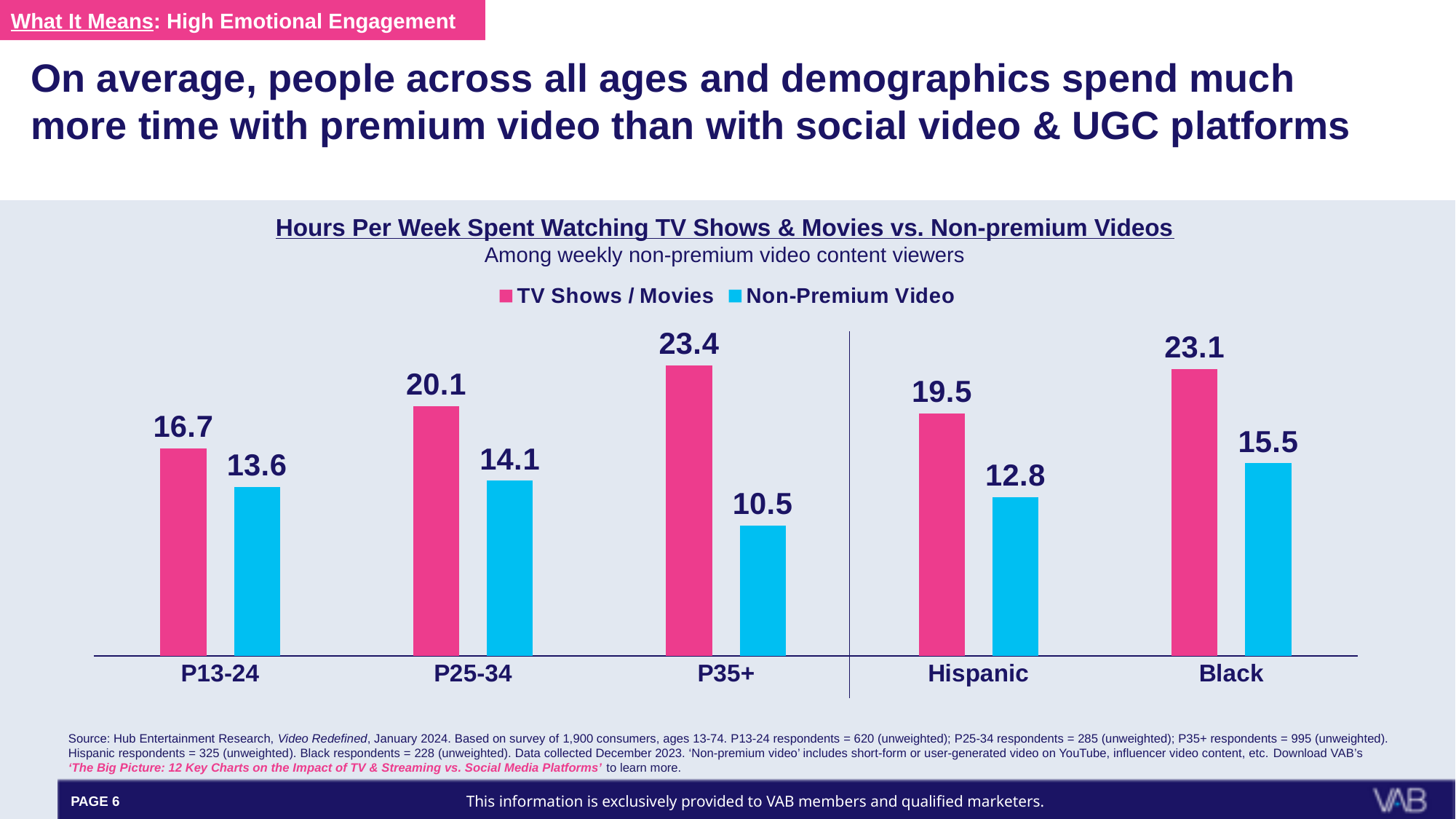
What is the value for Non-Premium Video for Hispanic? 12.8 What is the difference between TV Shows / Movies and Non-Premium Video for P35+? 12.9 What is the difference between TV Shows / Movies and Non-Premium Video for P25-34? 6.0 What is the value for TV Shows / Movies for P13-24? 16.7 How many series does the legend list? 2 Which category has the highest TV Shows / Movies value? P35+ What is the value for TV Shows / Movies for Black? 23.1 How many categories are shown on the x axis? 5 What kind of chart is shown on the slide? Bar chart Which is larger, the Non-Premium Video value for Black or for P13-24? Black What is the value for Non-Premium Video for P35+? 10.5 Which category has the lowest Non-Premium Video value? P35+